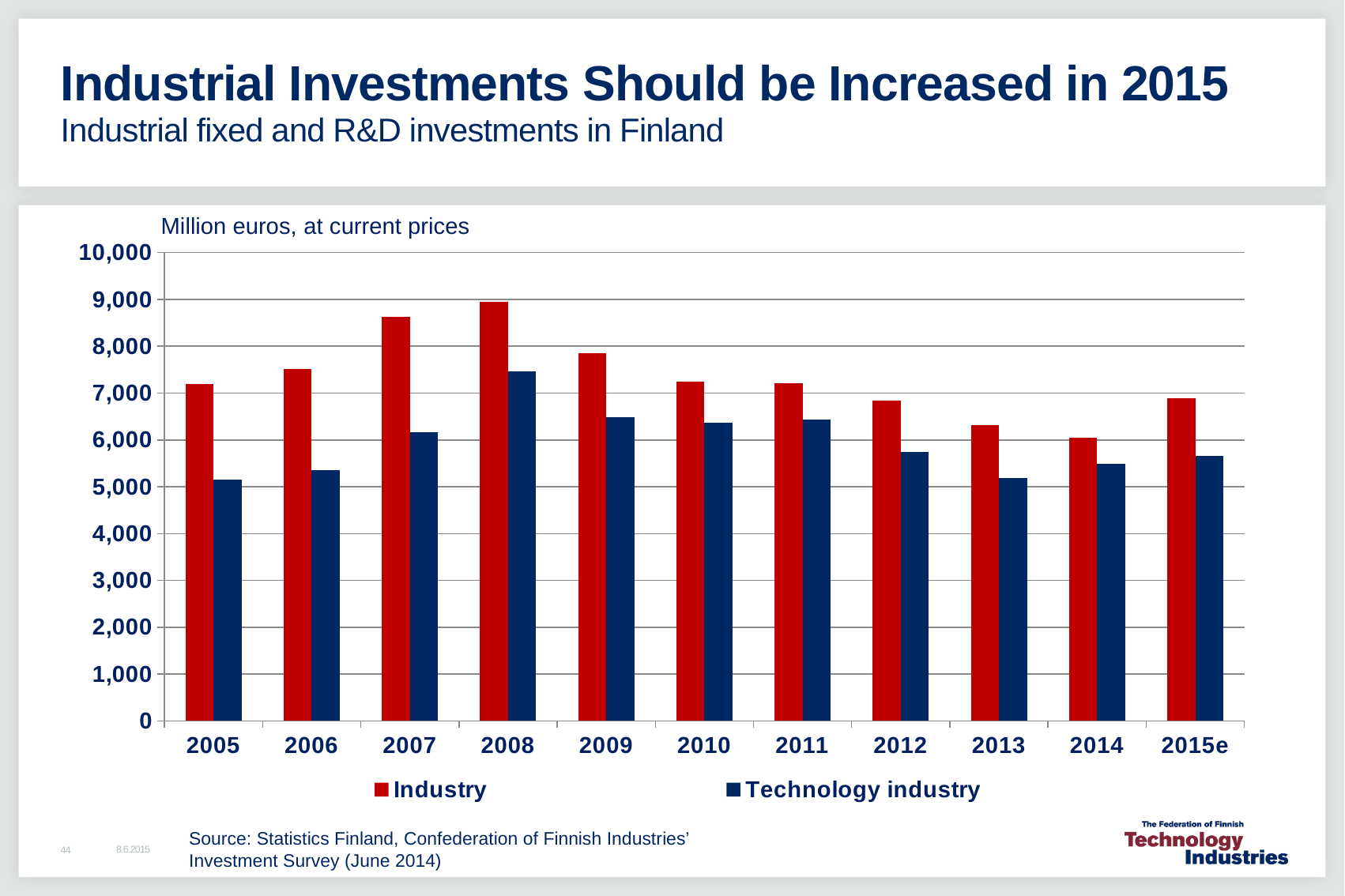
What kind of chart is shown on the slide? bar chart How many series does the legend list? 2 Is the Industry value for 2014 greater or less than 7,000? less What unit is stated above the chart? Million euros, at current prices How many years are shown on the x axis? 11 In which year is the Industry value lowest? 2014 Is the Industry value for 2008 greater or less than 8,000? greater Which is larger, the Industry value for 2007 or for 2009? 2007 In which year is the Technology industry value highest? 2008 Is the Technology industry value for 2013 greater or less than 6,000? less Do the Industry values rise or fall from 2008 to 2014? fall In which year is the Industry value highest? 2008